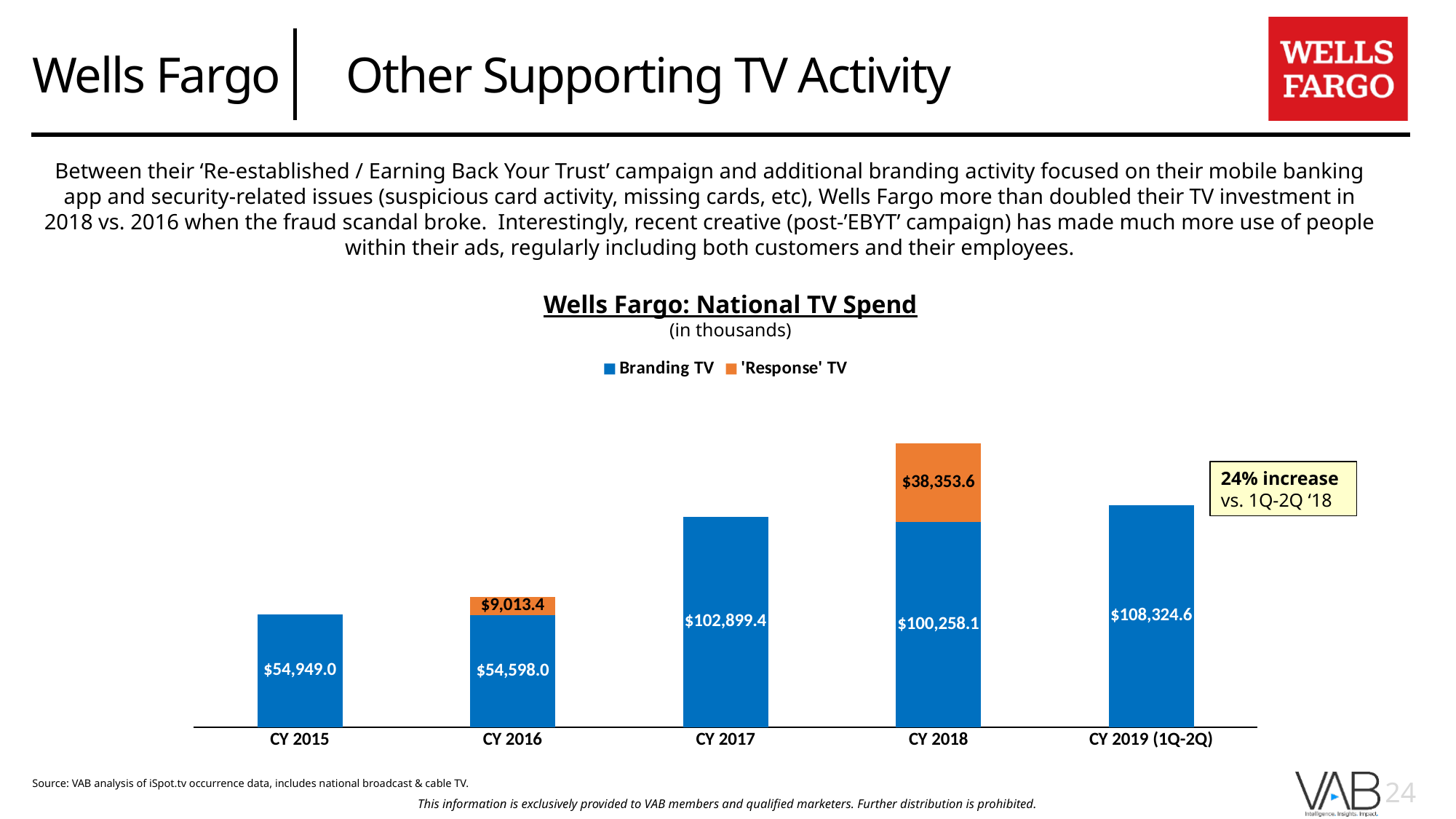
Which category has the highest Branding TV value? CY 2019 (1Q-2Q) Which is larger, the Branding TV value for CY 2017 or for CY 2018? CY 2017 How many series does the legend list? 2 Which category has the lowest Branding TV value? CY 2016 What is the total of the stacked bar for CY 2016? $63,611.4 What is the difference between the Branding TV values for CY 2019 (1Q-2Q) and CY 2018? $8,066.5 What is the 'Response' TV value for CY 2018? $38,353.6 What is the 'Response' TV value for CY 2016? $9,013.4 What is the Branding TV value for CY 2017? $102,899.4 What type of chart is shown on the slide? Stacked bar chart What is the total of the stacked bar for CY 2018? $138,611.7 How many categories are shown on the x axis? 5